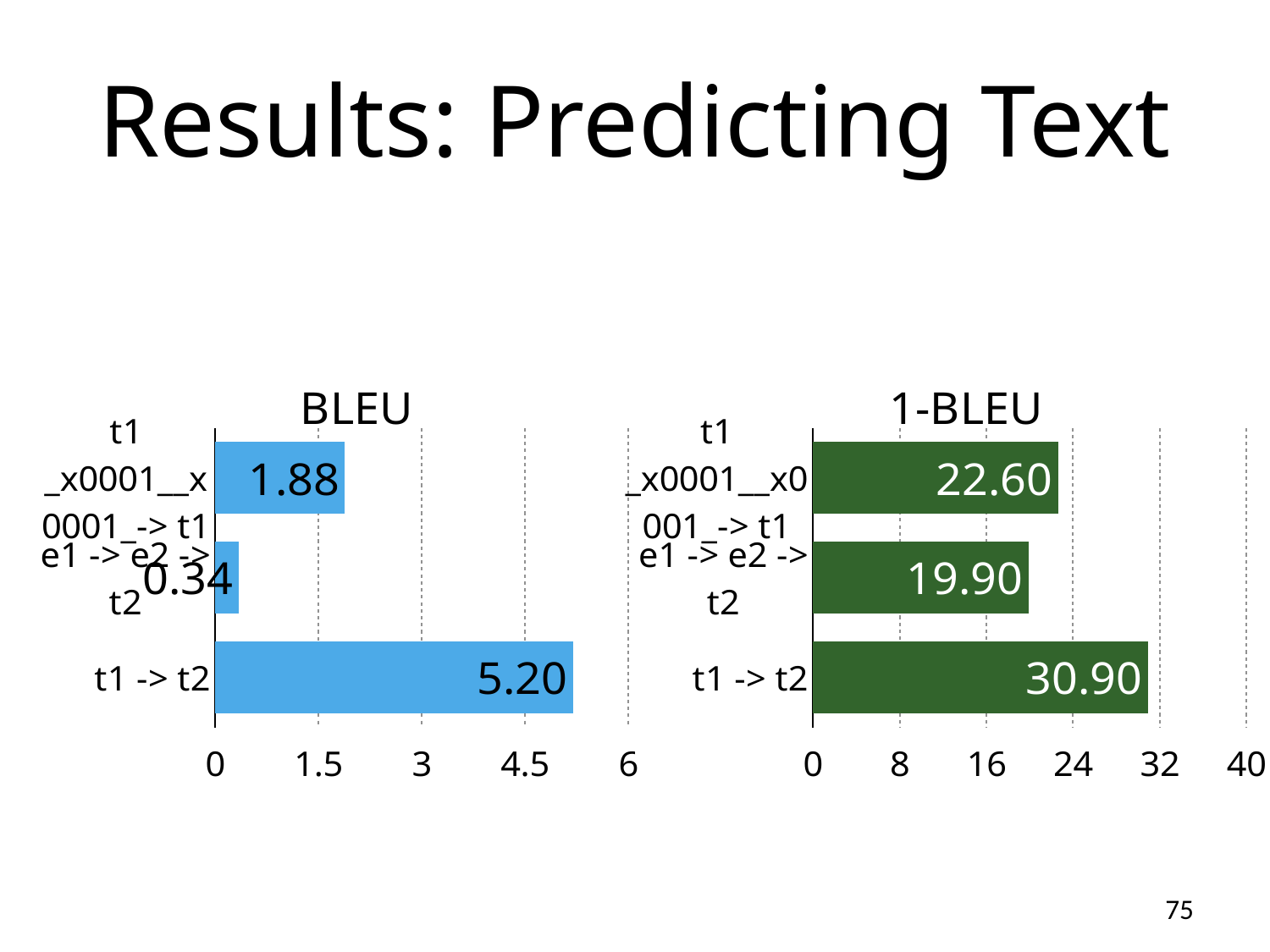
In the 1-BLEU chart, what is the value for t1 -> t2? 30.90 In the BLEU chart, what is the value for t1 -> t2? 5.20 In the BLEU chart, what is the value for e1 -> e2 -> t2? 0.34 In the 1-BLEU chart, what is the difference between the values for t1 -> t2 and e1 -> e2 -> t2? 11.00 What kind of chart is the 1-BLEU chart? bar chart In the 1-BLEU chart, what is the value for e1 -> e2 -> t2? 19.90 In the BLEU chart, what is the difference between the values for t1 -> t2 and e1 -> e2 -> t2? 4.86 In the 1-BLEU chart, which category has the lowest value? e1 -> e2 -> t2 How many categories are shown in the BLEU chart? 3 In the BLEU chart, which category has the highest value? t1 -> t2 In the BLEU chart, which category has the lowest value? e1 -> e2 -> t2 In the 1-BLEU chart, which category has the highest value? t1 -> t2